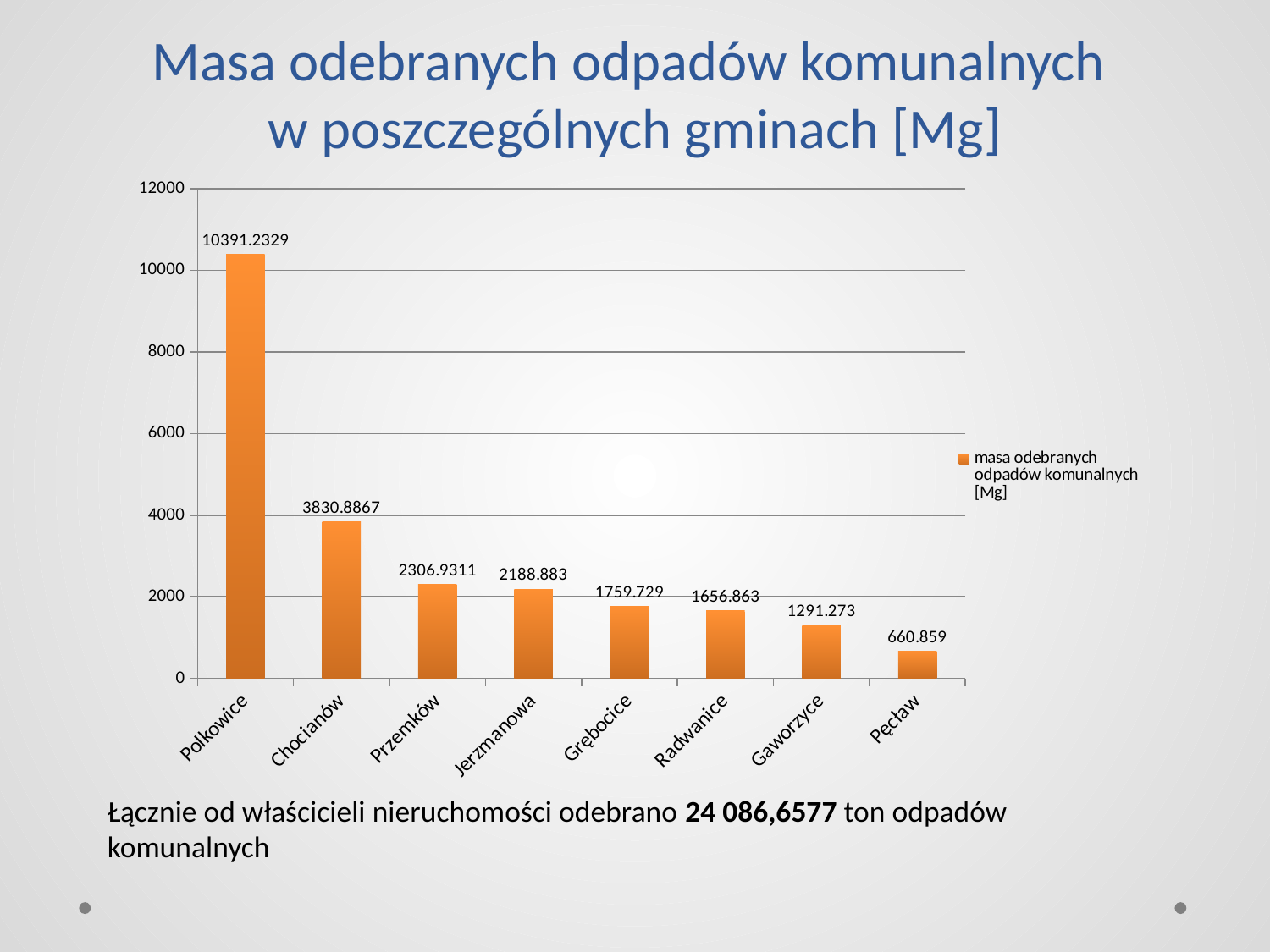
Which gmina has the lowest mass of collected municipal waste? Pęcław Which is larger, the value for Radwanice or the value for Gaworzyce? Radwanice What is the value for Pęcław? 660.859 How many gminas are shown on the x axis? 8 What kind of chart is shown on the slide? Bar chart What is the value for Polkowice? 10391.2329 What is the difference between the values for Przemków and Jerzmanowa? 118.0481 What is the value for Grębocice? 1759.729 What is the difference between the values for Polkowice and Chocianów? 6560.3462 Which gmina has the highest mass of collected municipal waste? Polkowice Do the values rise or fall from left to right along the x axis? Fall What is the value for Chocianów? 3830.8867